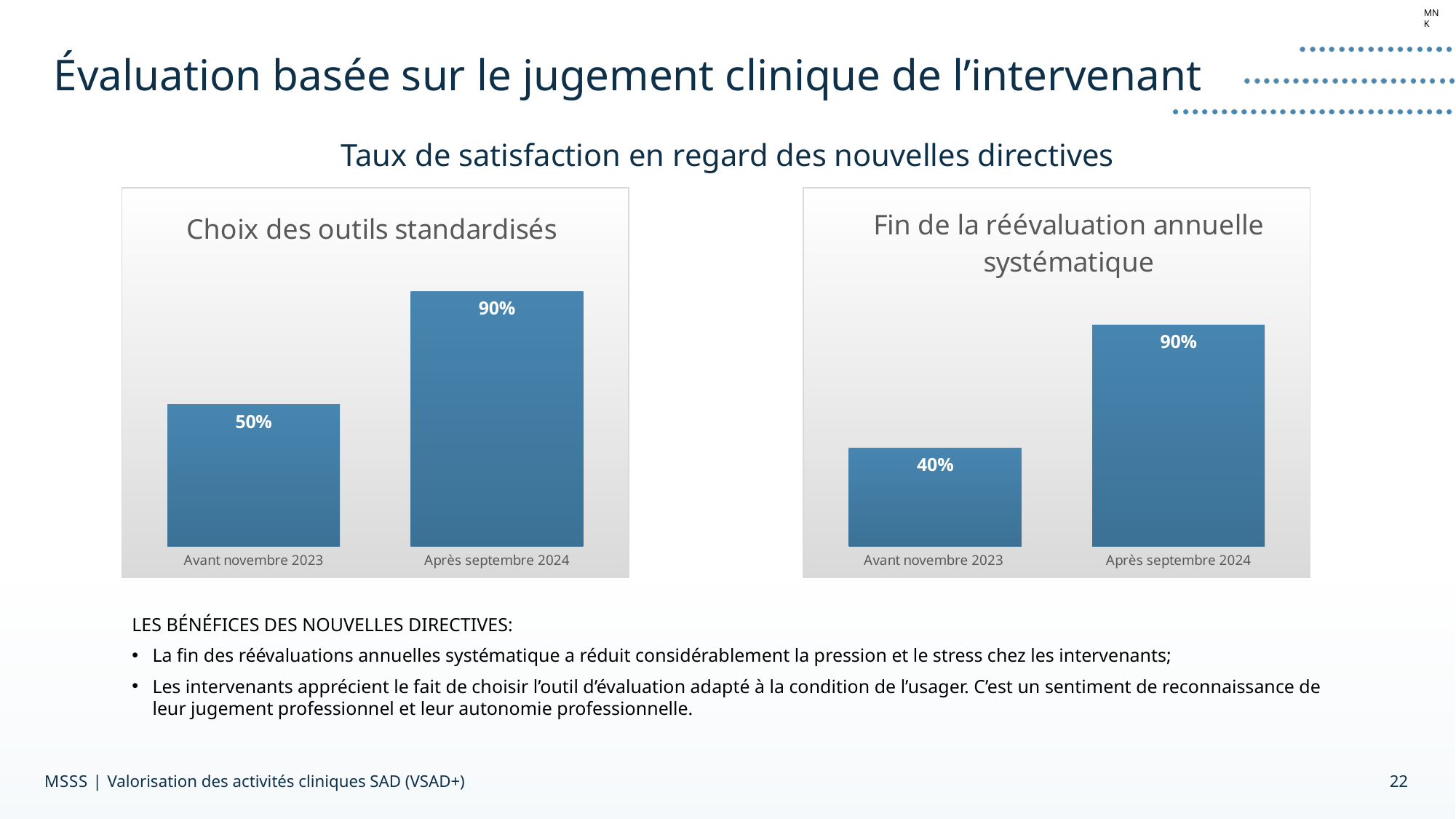
In the 'Fin de la réévaluation annuelle systématique' chart, what is the difference between the Après septembre 2024 and Avant novembre 2023 values? 50% In the 'Fin de la réévaluation annuelle systématique' chart, do the values rise or fall from Avant novembre 2023 to Après septembre 2024? Rise How many categories are shown in the 'Choix des outils standardisés' chart? 2 In the 'Fin de la réévaluation annuelle systématique' chart, what is the value for Avant novembre 2023? 40% In the 'Choix des outils standardisés' chart, what is the value for Après septembre 2024? 90% In the 'Choix des outils standardisés' chart, which is larger: the value for Avant novembre 2023 or Après septembre 2024? Après septembre 2024 In the 'Choix des outils standardisés' chart, what is the value for Avant novembre 2023? 50% In the 'Choix des outils standardisés' chart, which category has the highest value? Après septembre 2024 In the 'Choix des outils standardisés' chart, what is the difference between the Après septembre 2024 and Avant novembre 2023 values? 40% What kind of chart is the 'Fin de la réévaluation annuelle systématique' chart? Bar chart In the 'Fin de la réévaluation annuelle systématique' chart, what is the value for Après septembre 2024? 90% In the 'Fin de la réévaluation annuelle systématique' chart, which category has the lowest value? Avant novembre 2023